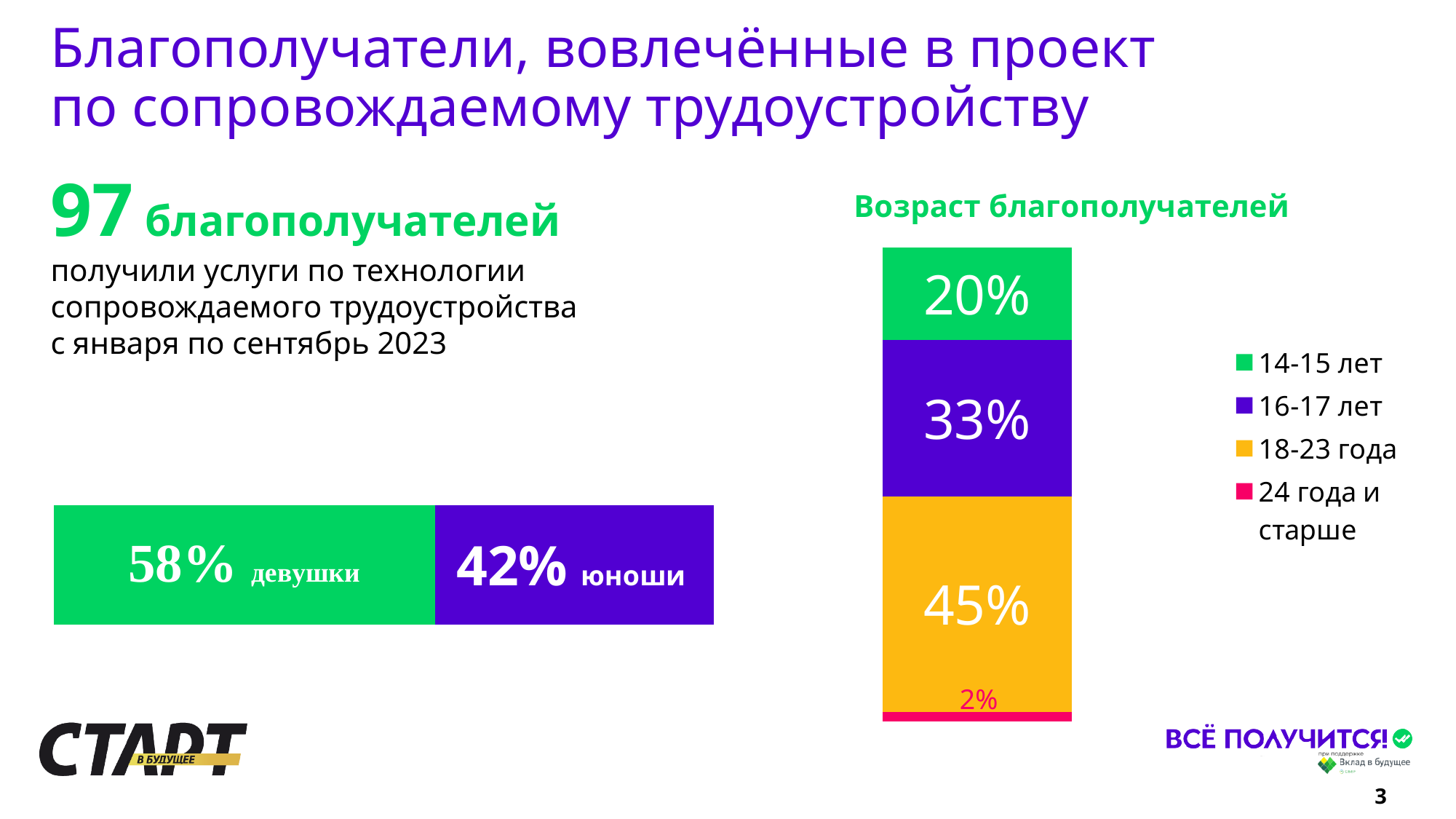
What kind of chart is "Возраст благополучателей"? Stacked bar chart In the chart titled "Возраст благополучателей", which is larger: the 16-17 лет share or the 14-15 лет share? 16-17 лет In the chart titled "Возраст благополучателей", what is the value for the 18-23 года group? 45% In the horizontal bar on the left of the slide, what is the share of девушки? 58% In the chart titled "Возраст благополучателей", which age group has the smallest share? 24 года и старше In the chart titled "Возраст благополучателей", what is the difference between the 18-23 года and 16-17 лет shares? 12% In the chart titled "Возраст благополучателей", what is the value for the 24 года и старше group? 2% In the chart titled "Возраст благополучателей", what is the value for the 16-17 лет group? 33% In the chart titled "Возраст благополучателей", what is the value for the 14-15 лет group? 20% In the chart titled "Возраст благополучателей", which age group has the largest share? 18-23 года How many age groups does the legend of the chart "Возраст благополучателей" list? 4 In the chart titled "Возраст благополучателей", what colour is the 18-23 года segment? Orange